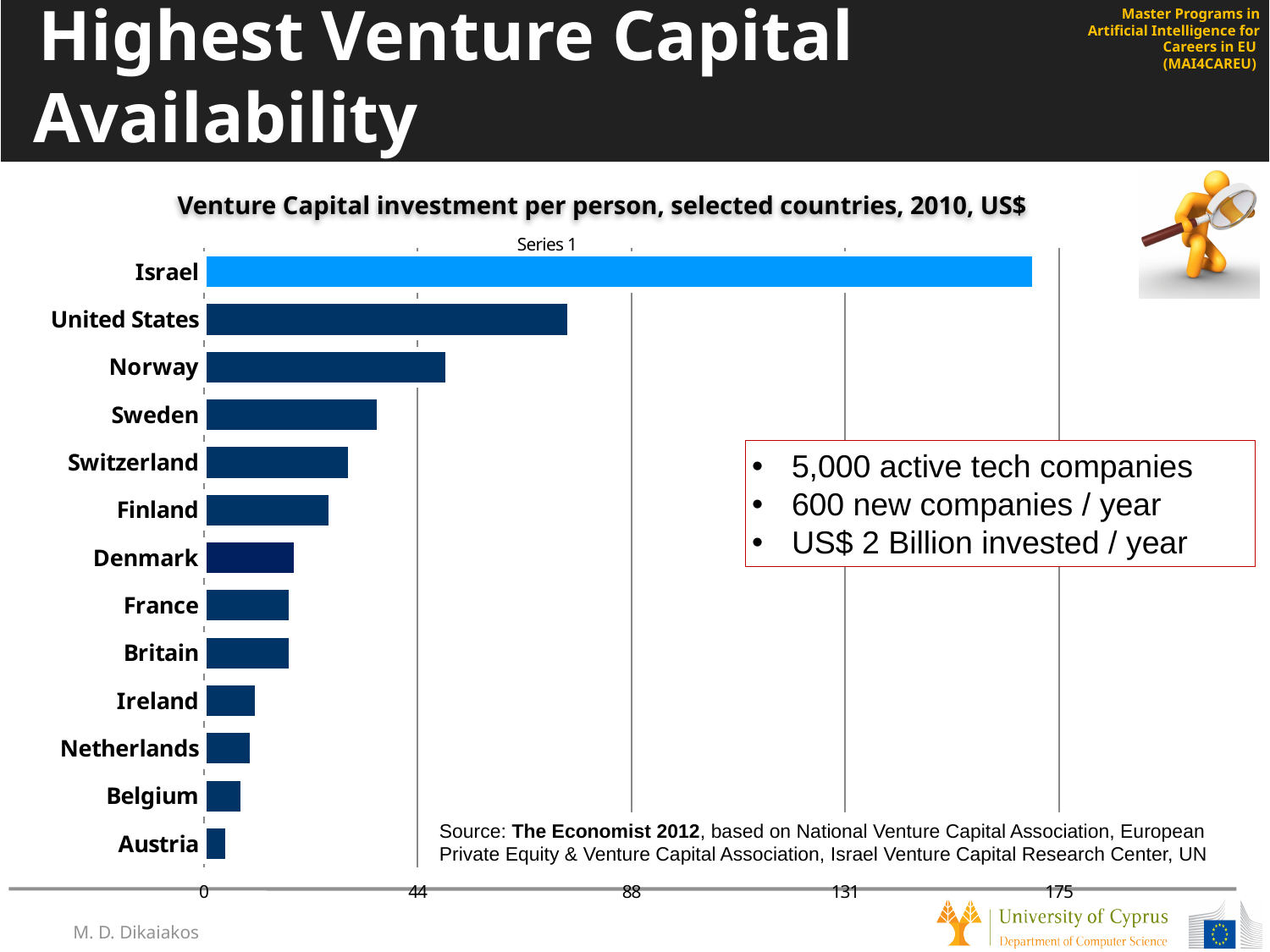
What kind of chart is shown on the slide? Bar chart Is the value for United States greater or less than 88? less Which has a larger value, Norway or Sweden? Norway Do the bar values increase or decrease going from the top country to the bottom country? decrease Which has a larger value, Israel or United States? Israel Is the value for Sweden greater or less than 44? less Which country has the highest venture capital investment per person? Israel How many series does the chart legend list? 1 Which country has the lowest venture capital investment per person? Austria What is the title of the chart? Venture Capital investment per person, selected countries, 2010, US$ How many countries are shown in the chart? 13 Is the value for Israel greater or less than 131? greater